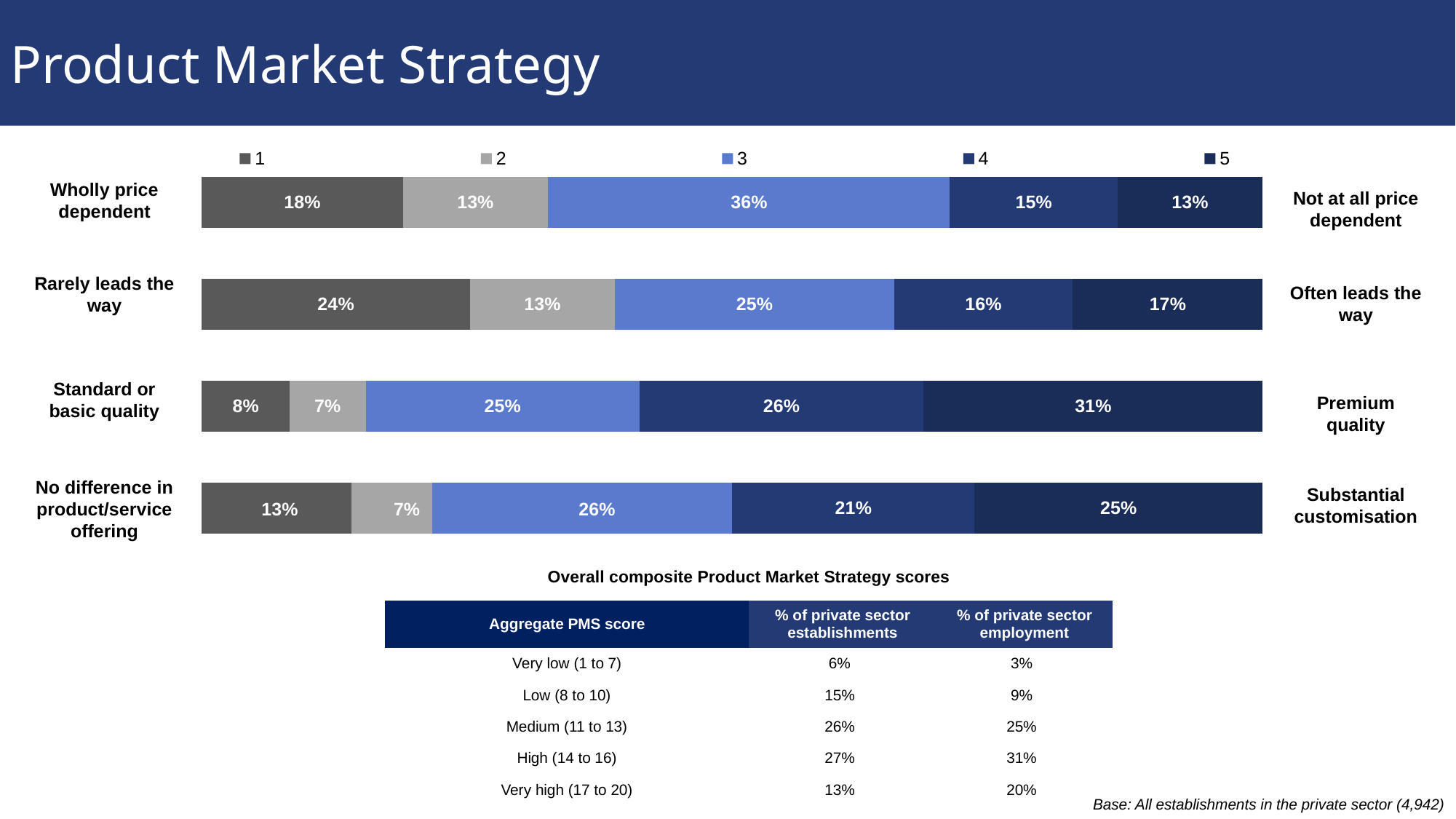
How many series does the chart legend list? 5 What label appears at the right end of the third bar of the chart? Premium quality In the 'Rarely leads the way' / 'Often leads the way' bar, which is larger: the series 5 value or the series 4 value? Series 5 What is the value for series 4 in the 'No difference in product/service offering' / 'Substantial customisation' bar? 21% What is the difference between the series 3 value and the series 1 value in the 'Wholly price dependent' / 'Not at all price dependent' bar? 18% What is the value for series 1 in the 'Rarely leads the way' / 'Often leads the way' bar? 24% What kind of chart is shown on the slide? Stacked bar chart Which series has the smallest segment in the 'No difference in product/service offering' / 'Substantial customisation' bar? 2 Which series has the largest segment in the 'Standard or basic quality' / 'Premium quality' bar? 5 How many bars (rows) does the chart have? 4 What is the value for series 5 in the 'Standard or basic quality' / 'Premium quality' bar? 31% What is the value for series 3 in the 'Wholly price dependent' / 'Not at all price dependent' bar? 36%